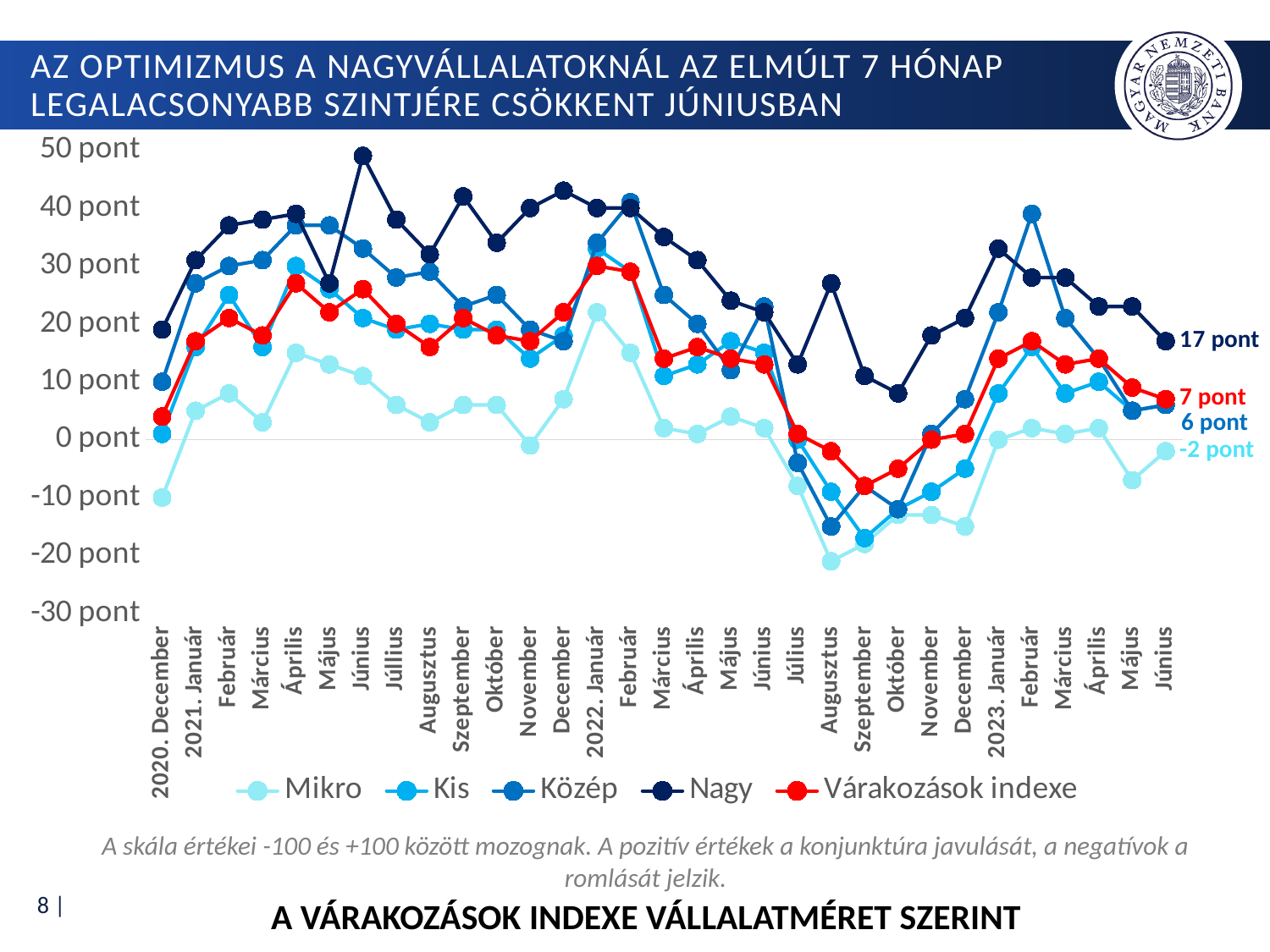
Which series has the lowest value in Június 2023? Mikro How many series does the legend list? 5 Is the value for the Nagy series in Június 2021 greater or less than 40 pont? greater What kind of chart is shown on the slide? line chart What is the value of the Nagy series in Június 2023? 17 pont Is the value for the Mikro series in Augusztus 2022 greater or less than -10 pont? less Does the Nagy series rise or fall from Február 2023 to Június 2023? fall Which series has the highest value in Június 2023? Nagy What is the value of the Mikro series in Június 2023? -2 pont What is the difference between the Nagy value and the Várakozások indexe value in Június 2023? 10 pont What is the value of the Várakozások indexe series in Június 2023? 7 pont How many months are shown on the x axis? 31